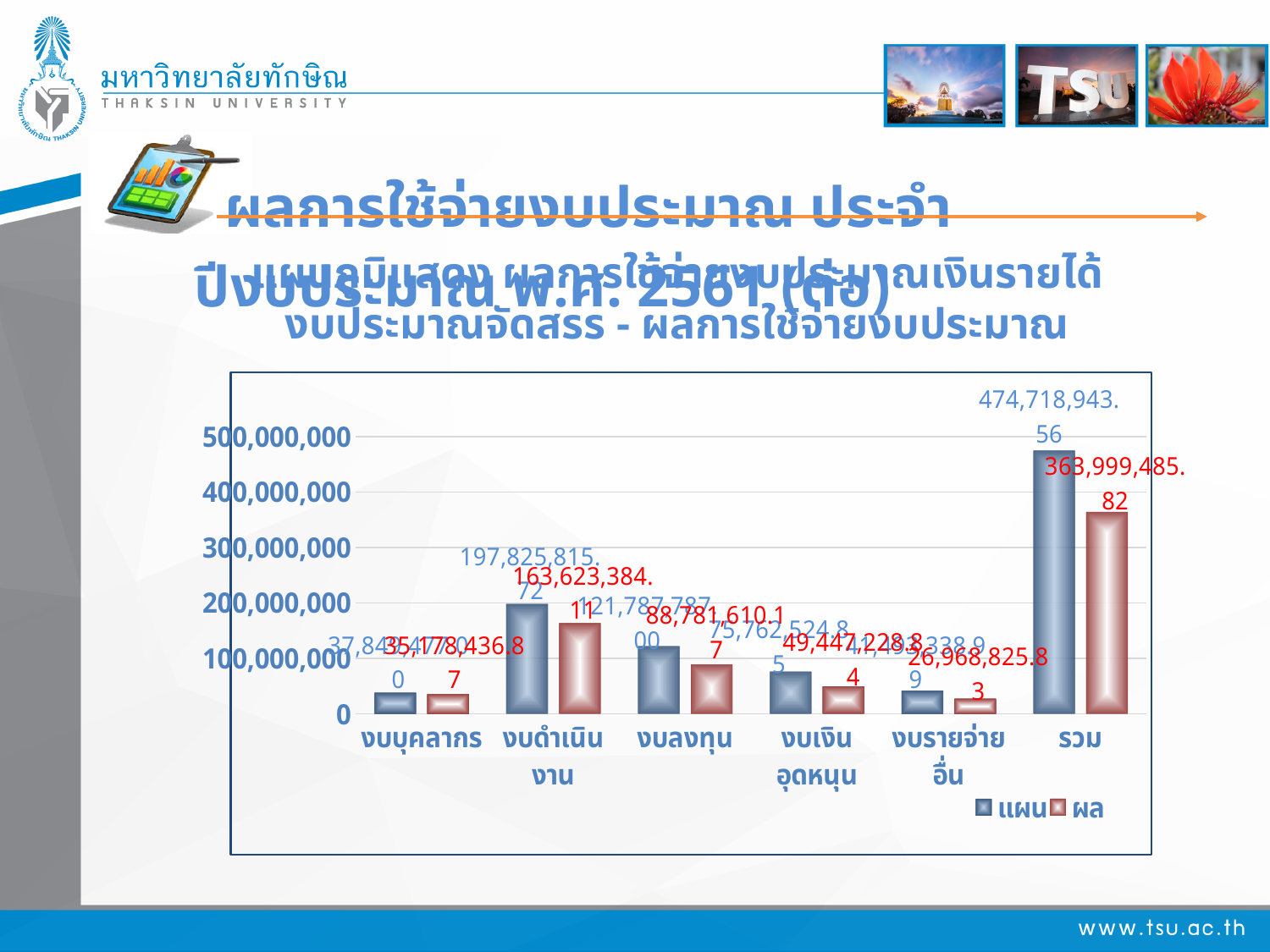
Is the แผน value for งบลงทุน greater or less than 100,000,000? greater Which category has the lowest ผล value? งบรายจ่ายอื่น What is the แผน value for รวม? 474,718,943.56 What is the ผล value for งบดำเนินงาน? 163,623,384.11 How many series does the legend list? 2 What is the แผน value for งบดำเนินงาน? 197,825,815.72 What kind of chart is shown on the slide? bar chart What is the difference between the แผน and ผล values for รวม? 110,719,457.74 Which category has the highest แผน value? รวม How many categories are shown on the x axis? 6 For งบดำเนินงาน, which is larger, แผน or ผล? แผน What is the ผล value for รวม? 363,999,485.82